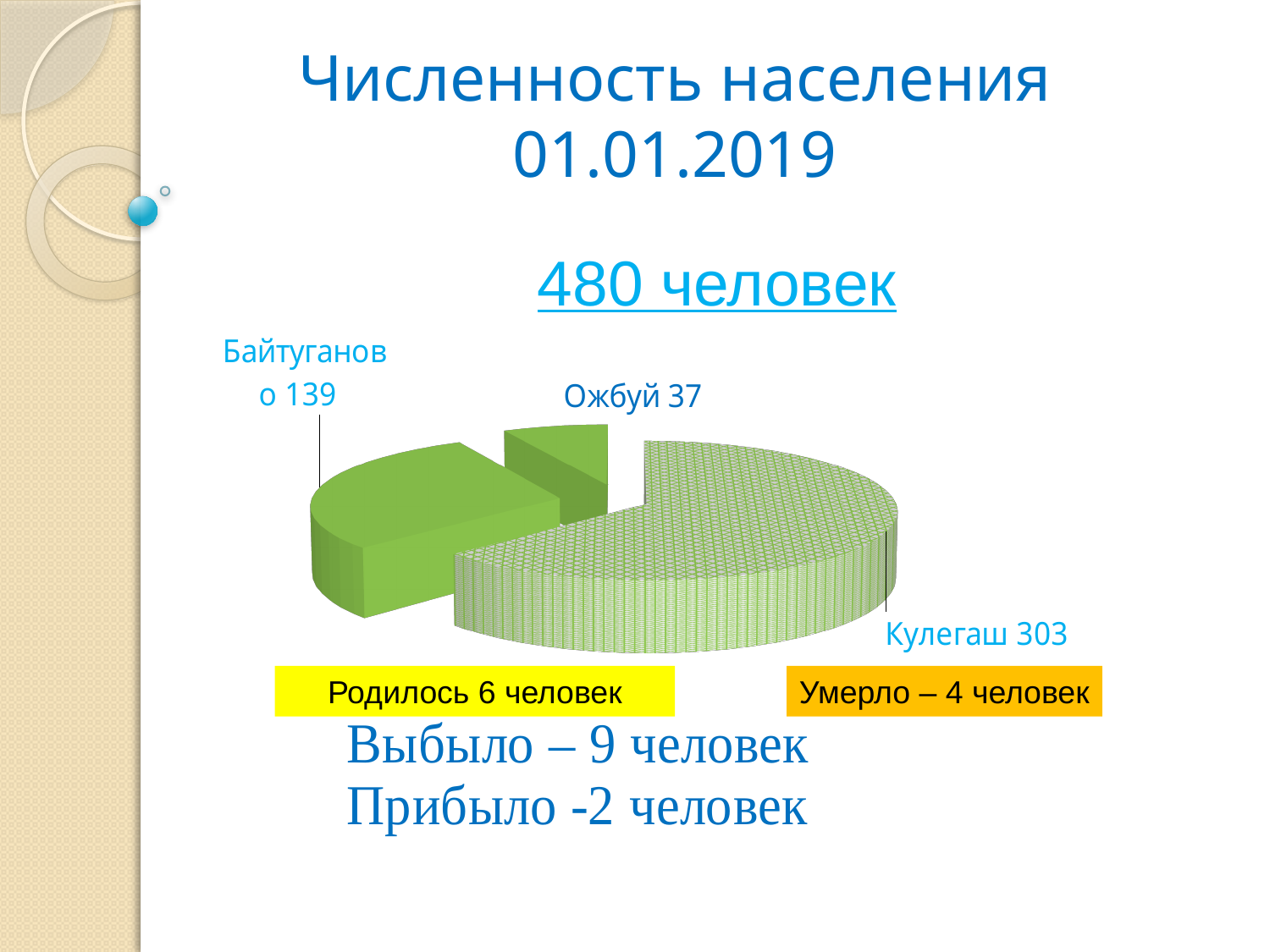
Which settlement has the smallest slice in the pie chart? Ожбуй What is the difference between the values for Байтуганово and Ожбуй? 102 What is the difference between the values for Кулегаш and Байтуганово? 164 What is the value for Байтуганово in the pie chart? 139 What is the title of the slide containing the chart? Численность населения 01.01.2019 What kind of chart is shown on the slide? Pie chart What total population figure is shown above the pie chart? 480 человек What is the value for Ожбуй in the pie chart? 37 How many slices does the pie chart have? 3 Which is larger, the value for Байтуганово or the value for Ожбуй? Байтуганово What is the value for Кулегаш in the pie chart? 303 Which settlement has the largest slice in the pie chart? Кулегаш